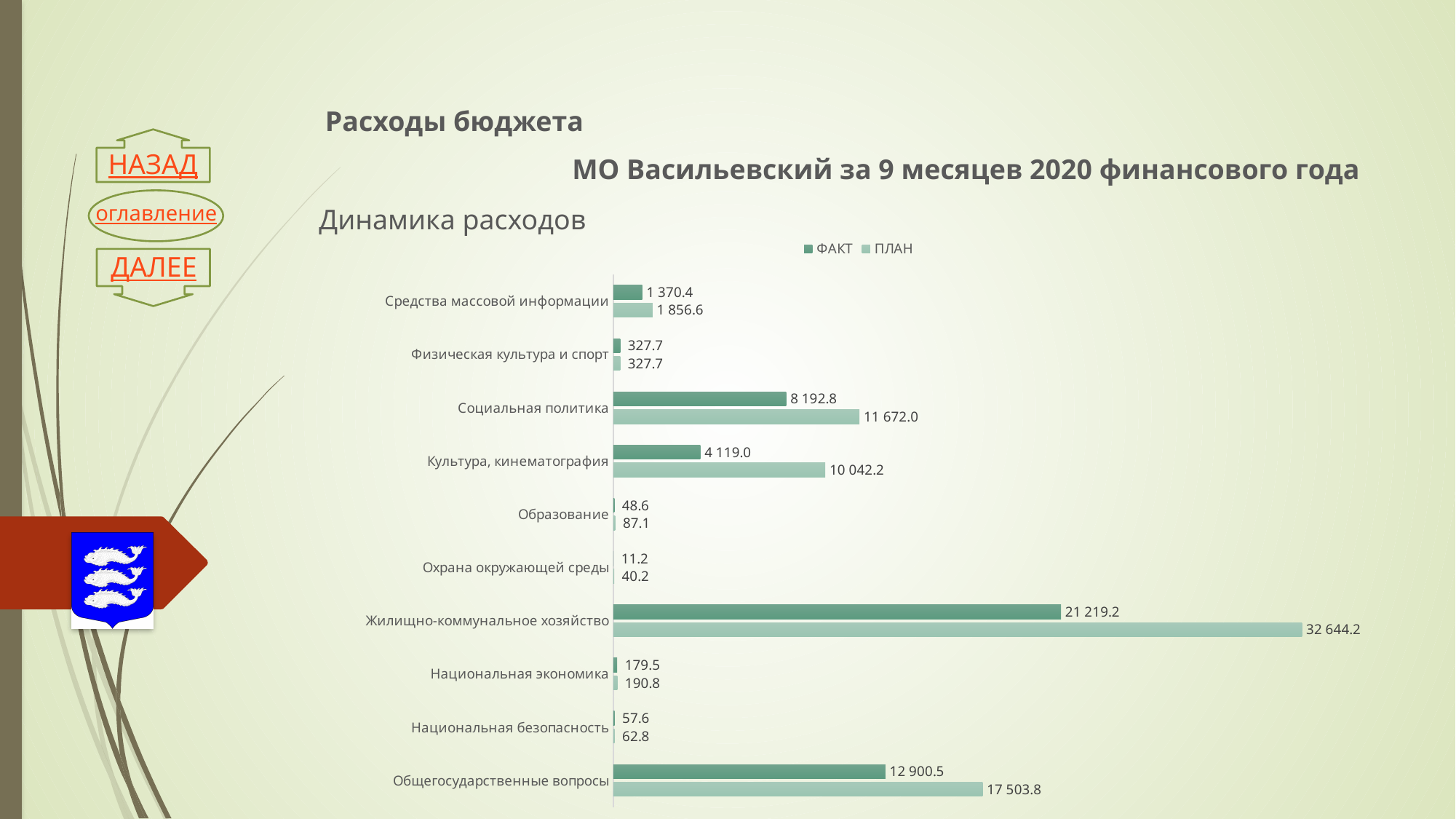
What is the ФАКТ value for Образование? 48.6 Which has the larger ФАКТ value: Социальная политика or Культура, кинематография? Социальная политика What is the ФАКТ value for Жилищно-коммунальное хозяйство? 21 219.2 What is the ПЛАН value for Культура, кинематография? 10 042.2 What is the ПЛАН value for Социальная политика? 11 672.0 How many series does the legend list? 2 How many categories are shown in the chart? 10 Which category has the lowest ФАКТ value? Охрана окружающей среды What is the difference between the ПЛАН and ФАКТ values for Жилищно-коммунальное хозяйство? 11 425.0 What is the difference between the ПЛАН and ФАКТ values for Общегосударственные вопросы? 4 603.3 What kind of chart is shown on the slide? Bar chart Which category has the highest ПЛАН value? Жилищно-коммунальное хозяйство